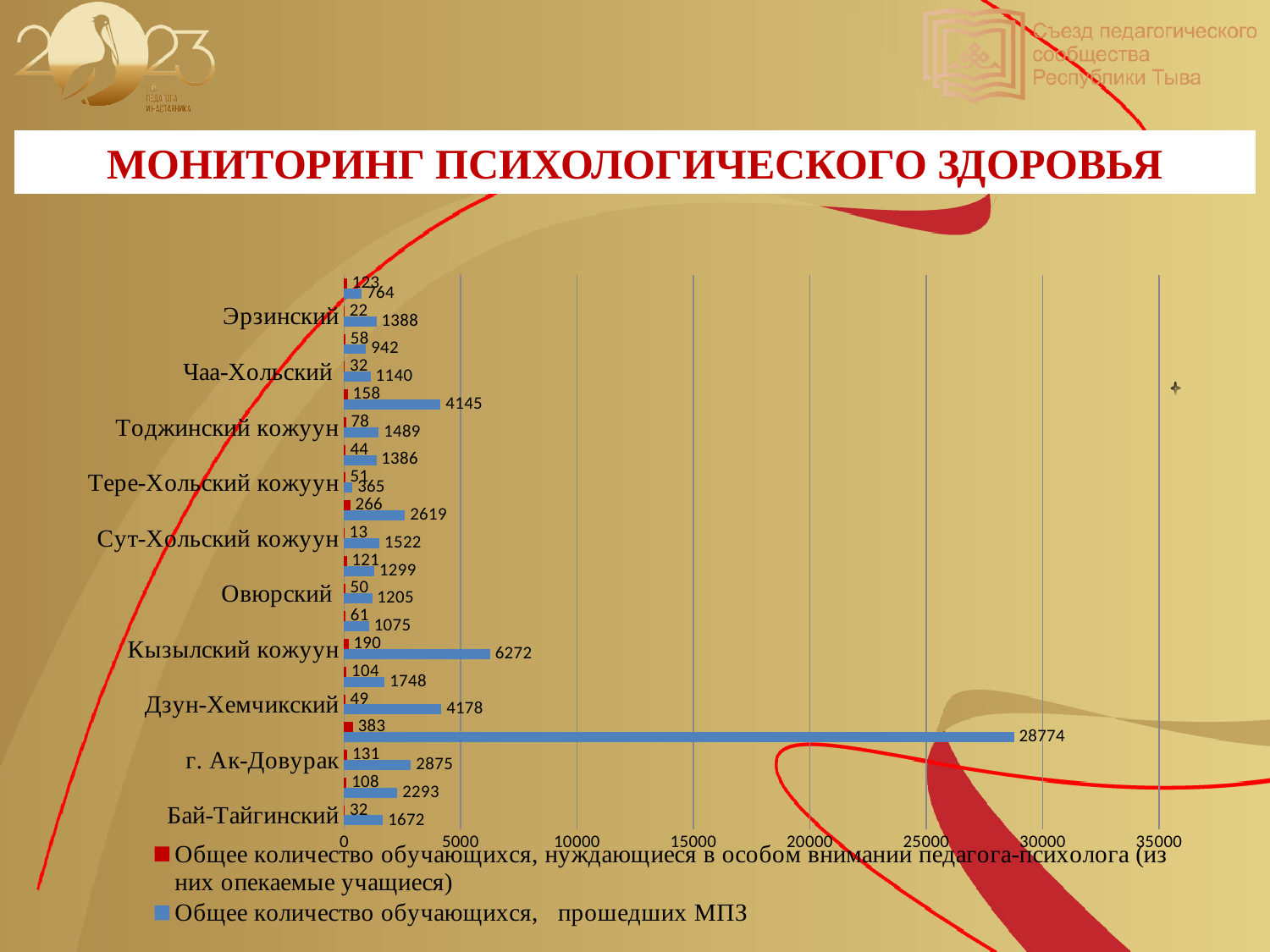
What is the value of 'Общее количество обучающихся, прошедших МПЗ' for Тере-Хольский кожуун? 365 What is the value of 'Общее количество обучающихся, прошедших МПЗ' for Бай-Тайгинский? 1672 How many series does the legend list? 2 What is the value of 'Общее количество обучающихся, нуждающиеся в особом внимании педагога-психолога' for г. Ак-Довурак? 131 What colour are the bars for the series 'Общее количество обучающихся, прошедших МПЗ'? blue What is the difference between the two series values for Дзун-Хемчикский (4178 and 49)? 4129 What kind of chart is shown on the slide? bar chart Which has a larger value for 'Общее количество обучающихся, прошедших МПЗ': Кызылский кожуун or Дзун-Хемчикский? Кызылский кожуун What is the value of 'Общее количество обучающихся, прошедших МПЗ' for Кызылский кожуун? 6272 What is the value of 'Общее количество обучающихся, нуждающиеся в особом внимании педагога-психолога' for Сут-Хольский кожуун? 13 Is the value of 'Общее количество обучающихся, прошедших МПЗ' for Кызылский кожуун greater or less than 5000? greater Is the value of 'Общее количество обучающихся, прошедших МПЗ' for Овюрский greater or less than 5000? less